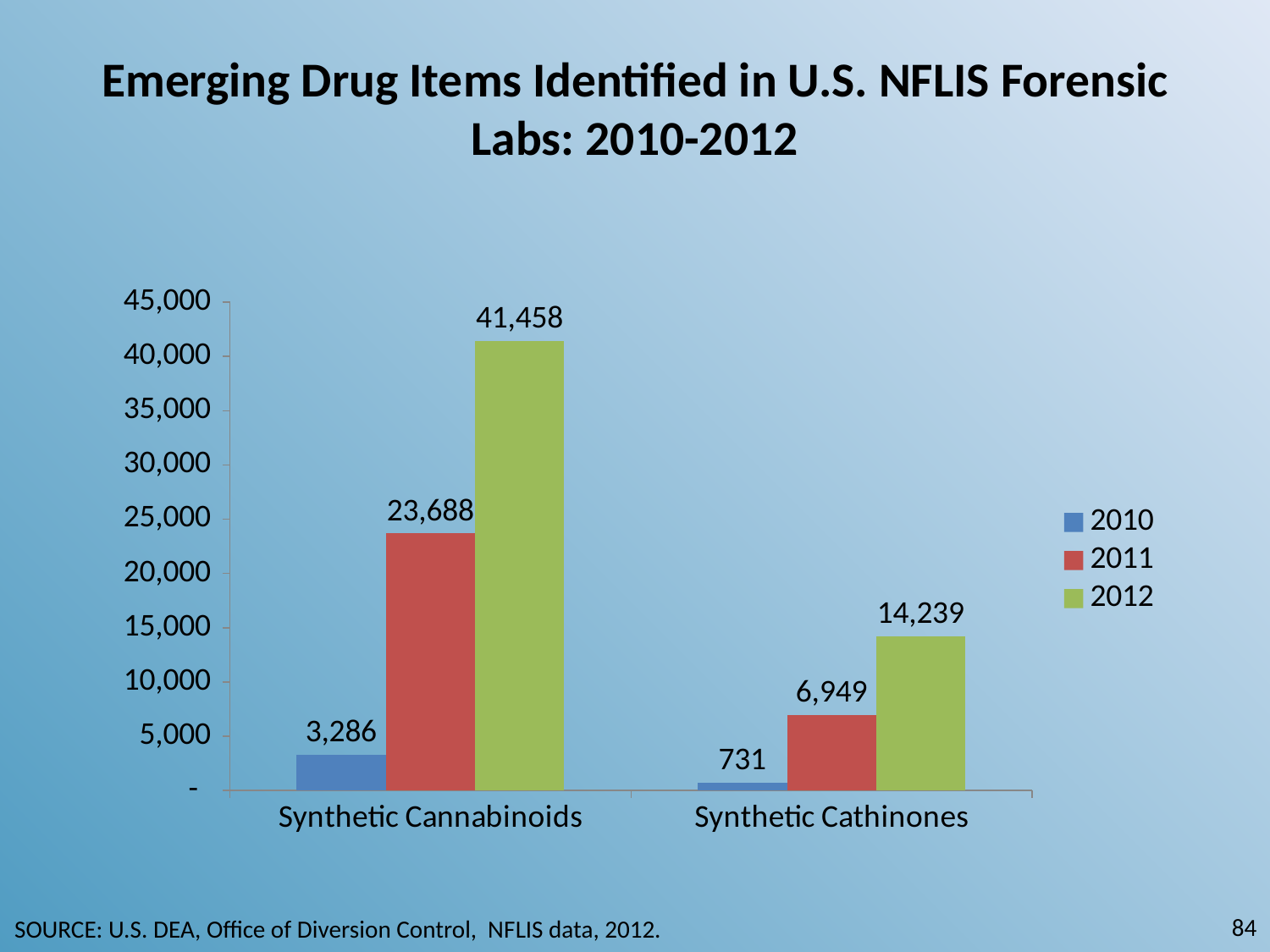
Which is larger: the 2012 value for Synthetic Cathinones or the 2011 value for Synthetic Cannabinoids? 2011 value for Synthetic Cannabinoids Do the values for Synthetic Cathinones rise or fall from 2010 to 2012? Rise What is the value for Synthetic Cathinones in 2010? 731 Which year has the lowest value for Synthetic Cannabinoids? 2010 What kind of chart is shown on the slide? Bar chart What is the value for Synthetic Cannabinoids in 2012? 41,458 Which year has the highest value for Synthetic Cathinones? 2012 What is the value for Synthetic Cathinones in 2012? 14,239 What is the value for Synthetic Cannabinoids in 2011? 23,688 What is the difference between the 2012 and 2011 values for Synthetic Cannabinoids? 17,770 How many series does the legend list? 3 What is the difference between the 2011 values for Synthetic Cannabinoids and Synthetic Cathinones? 16,739